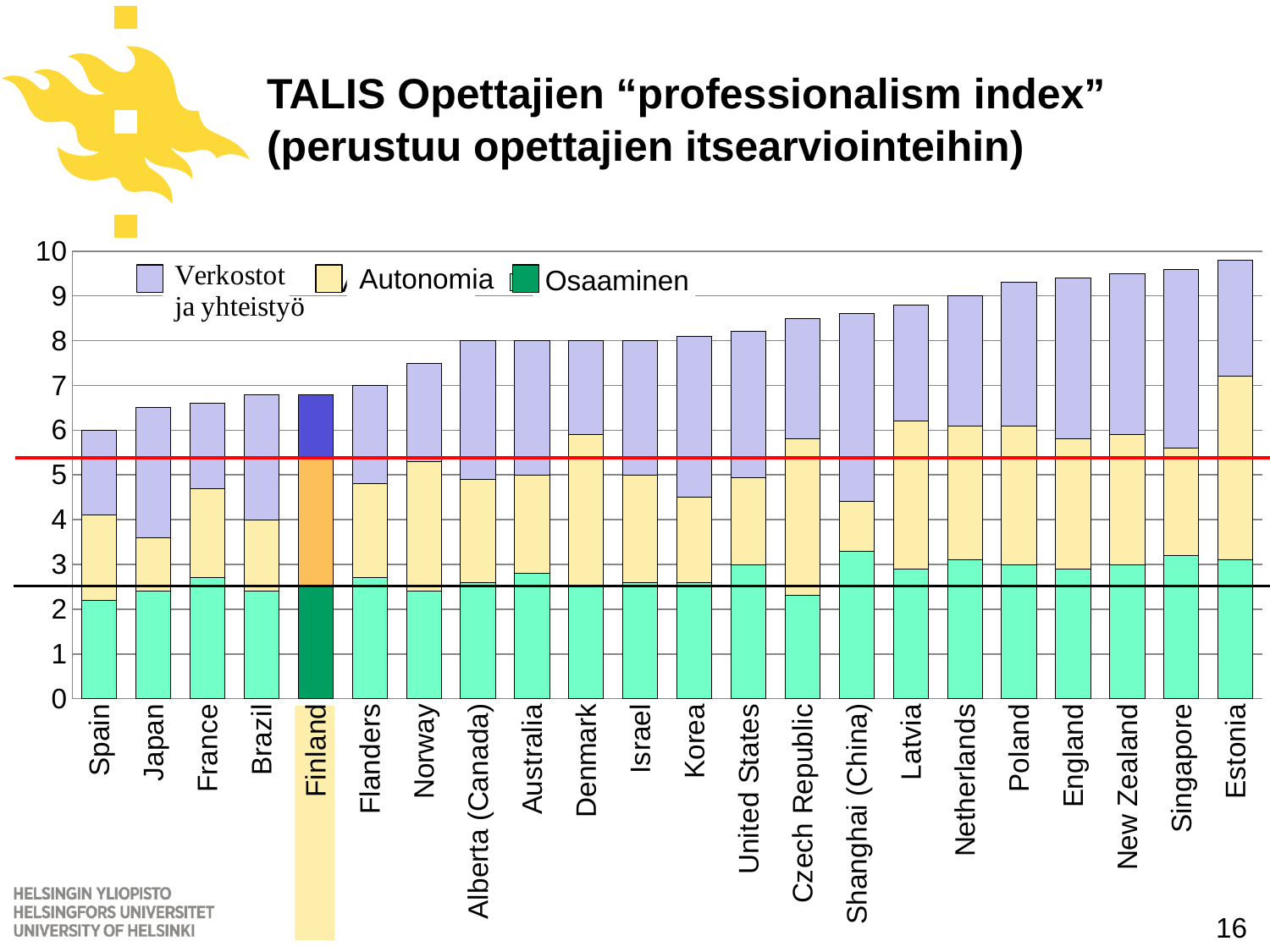
Is the Osaaminen value for Shanghai (China) greater or less than 3? greater Which has the larger total index, Singapore or Japan? Singapore Which country has the highest total professionalism index in the chart? Estonia What kind of chart is shown on the slide? Stacked bar chart Which has the larger Osaaminen value, Shanghai (China) or Czech Republic? Shanghai (China) Is the total value for Estonia greater or less than 9? greater Which country has the lowest total professionalism index in the chart? Spain How many series does the chart legend list? 3 How many countries or regions are shown along the x axis of the chart? 22 Is the total value for Spain greater or less than 7? less Do the total bar heights rise or fall moving from left to right along the x axis? Rise Which country's bar is highlighted with different colours in the chart? Finland